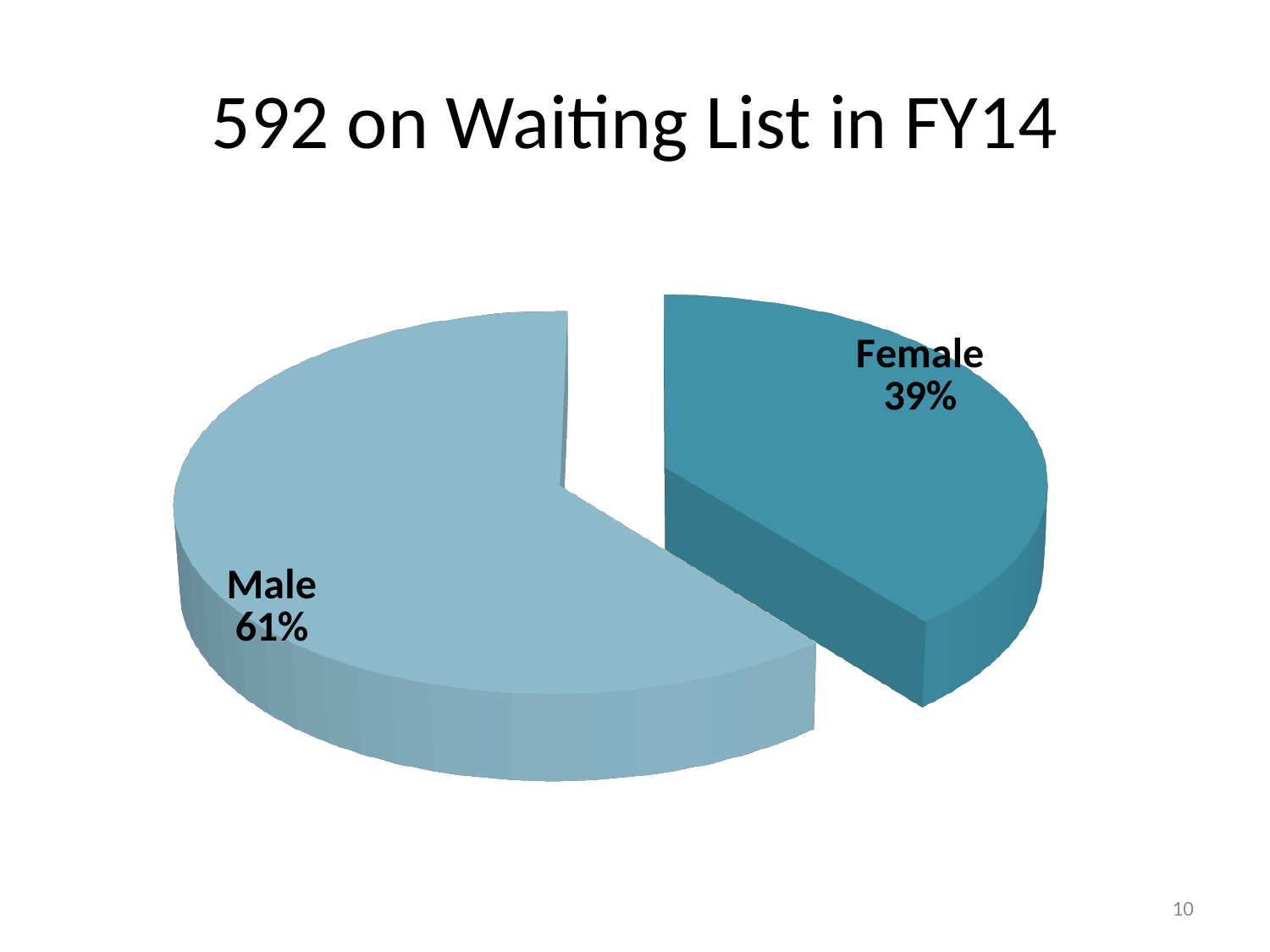
What is the difference in percentage points between the Male and Female slices? 22 What share of the pie is Female? 39% How many slices does the pie chart have? 2 What kind of chart is shown on the slide? Pie chart What share of the pie is Male? 61% Which slice is the smallest? Female What is the title of the slide? 592 on Waiting List in FY14 Which slice is pulled out (exploded) from the pie? Female Which is larger, the Male slice or the Female slice? Male Which slice is the largest? Male